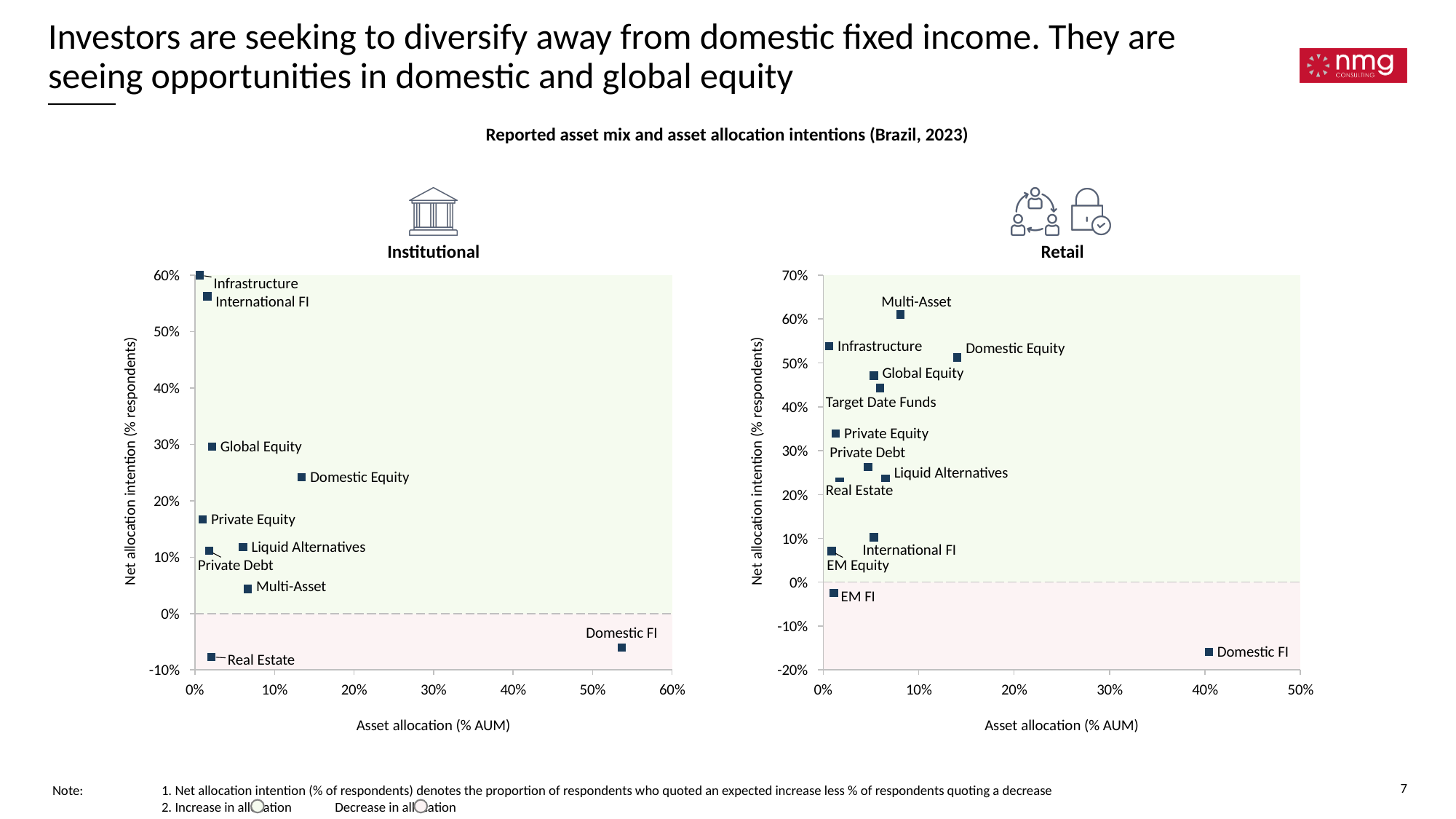
On the Retail chart, which asset class has the highest net allocation intention? Multi-Asset What kind of chart is the Institutional chart? Scatter chart What is the overall title shown above the two charts? Reported asset mix and asset allocation intentions (Brazil, 2023) On the Retail chart, which has the higher net allocation intention, Domestic Equity or International FI? Domestic Equity On the Institutional chart, which asset class has the highest asset allocation (% AUM)? Domestic FI On the Retail chart, is the asset allocation for Domestic FI greater or less than 30%? greater On the Retail chart, which asset class has the lowest net allocation intention? Domestic FI How many asset classes are plotted on the Institutional chart? 10 On the Institutional chart, is the asset allocation for Domestic Equity greater or less than 10%? greater On the Institutional chart, is the net allocation intention for Global Equity greater or less than 20%? greater On the Institutional chart, which asset class has the highest net allocation intention? Infrastructure